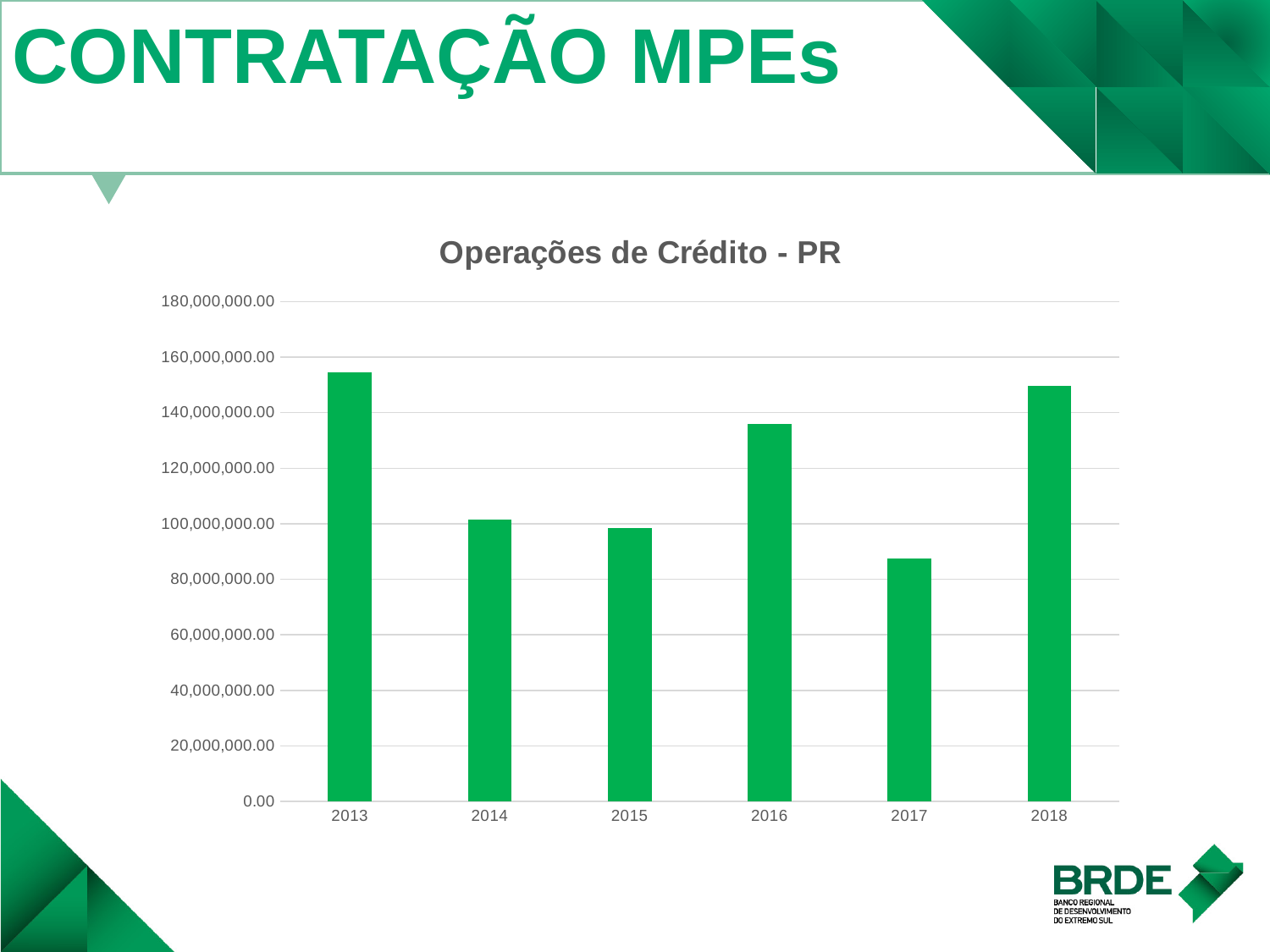
Which year has the lowest value in the chart? 2017 Is the value for 2016 greater or less than 120,000,000.00? greater Is the value for 2013 greater or less than 140,000,000.00? greater Do the values rise or fall from 2013 to 2015? fall Which is larger, the value for 2013 or the value for 2017? 2013 Is the value for 2018 greater or less than 140,000,000.00? greater What kind of chart is shown on the slide? bar chart What is the title of the chart? Operações de Crédito - PR How many years are shown on the x axis of the chart? 6 Which is larger, the value for 2016 or the value for 2014? 2016